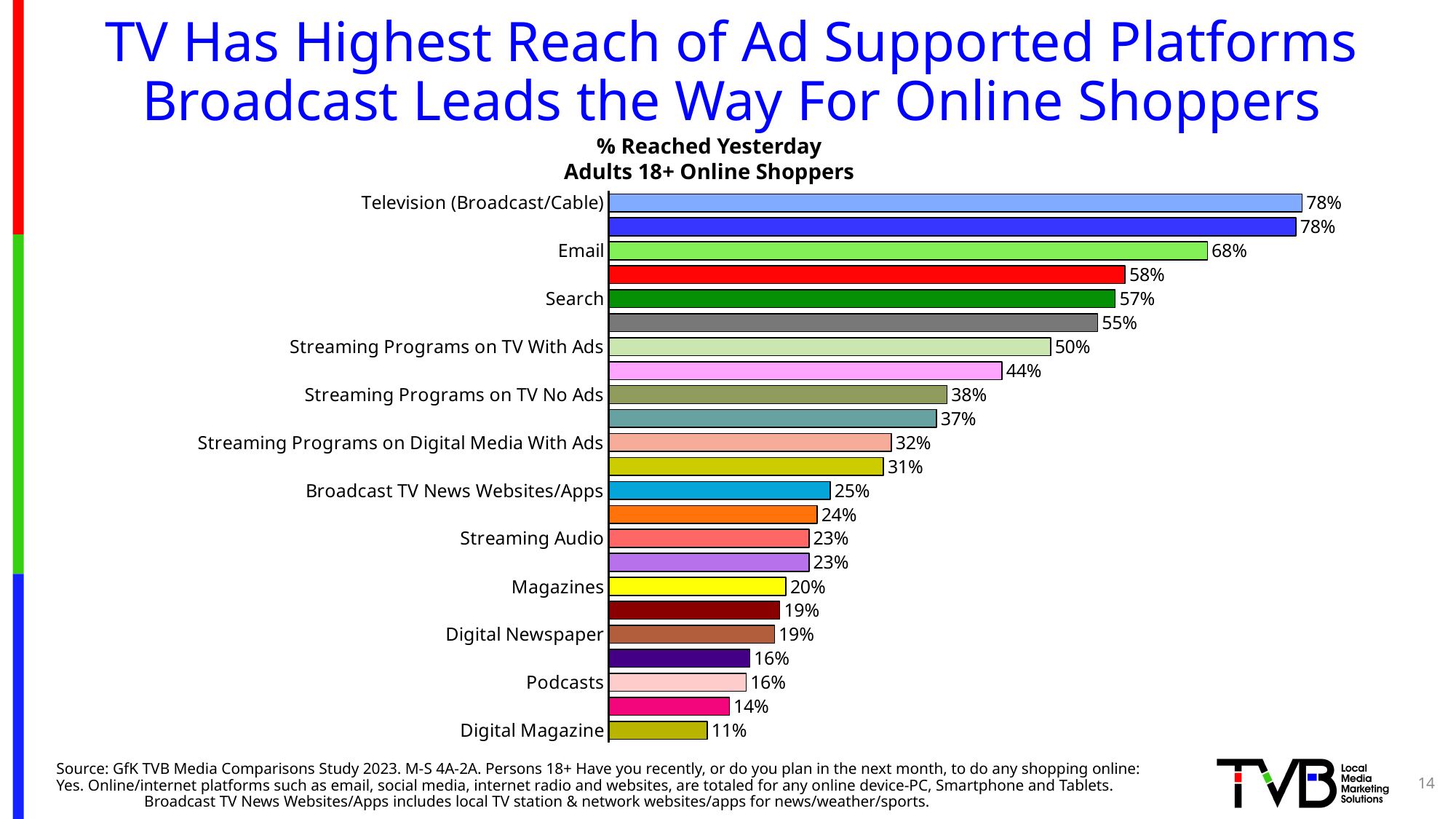
What is the difference between the values for Email and Search? 11% What is the value for Digital Magazine? 11% How many bars are plotted on the chart? 23 What is the value for Email? 68% What kind of chart is shown on the slide? Bar chart What is the difference between the values for Streaming Programs on TV With Ads and Streaming Programs on TV No Ads? 12% What is the value for Streaming Programs on TV With Ads? 50% Which is larger, the value for Magazines or the value for Podcasts? Magazines Which labeled category has the lowest value? Digital Magazine What is the subtitle printed above the chart? % Reached Yesterday Adults 18+ Online Shoppers What is the value for Broadcast TV News Websites/Apps? 25% What is the value for Television (Broadcast/Cable)? 78%